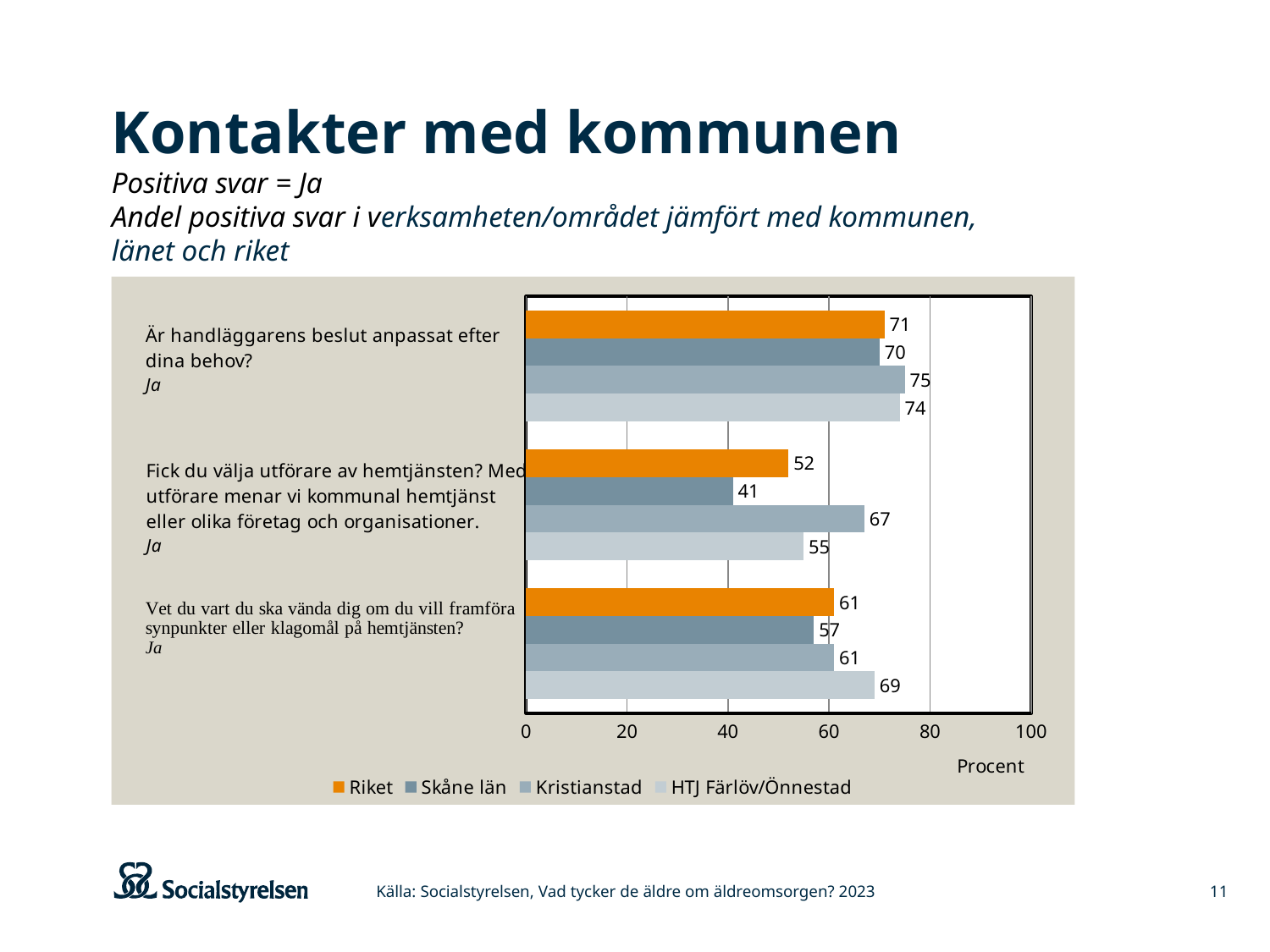
How many question categories are plotted on the chart? 3 Is the value for Riket for the question 'Fick du välja utförare av hemtjänsten?' greater or less than 60? less What is the value for Kristianstad for the question 'Är handläggarens beslut anpassat efter dina behov?'? 75 What is the value for HTJ Färlöv/Önnestad for the question 'Vet du vart du ska vända dig om du vill framföra synpunkter eller klagomål på hemtjänsten?'? 69 What is the difference between Kristianstad and Skåne län for the question 'Fick du välja utförare av hemtjänsten?'? 26 What is the value for Skåne län for the question 'Fick du välja utförare av hemtjänsten?'? 41 For the question 'Är handläggarens beslut anpassat efter dina behov?', which is larger: Riket or Kristianstad? Kristianstad What kind of chart is shown on the slide? bar chart Which series has the highest value for the question 'Vet du vart du ska vända dig om du vill framföra synpunkter eller klagomål på hemtjänsten?'? HTJ Färlöv/Önnestad What unit is shown on the x axis of the chart? Procent Which series has the lowest value for the question 'Fick du välja utförare av hemtjänsten?'? Skåne län How many series does the legend list? 4